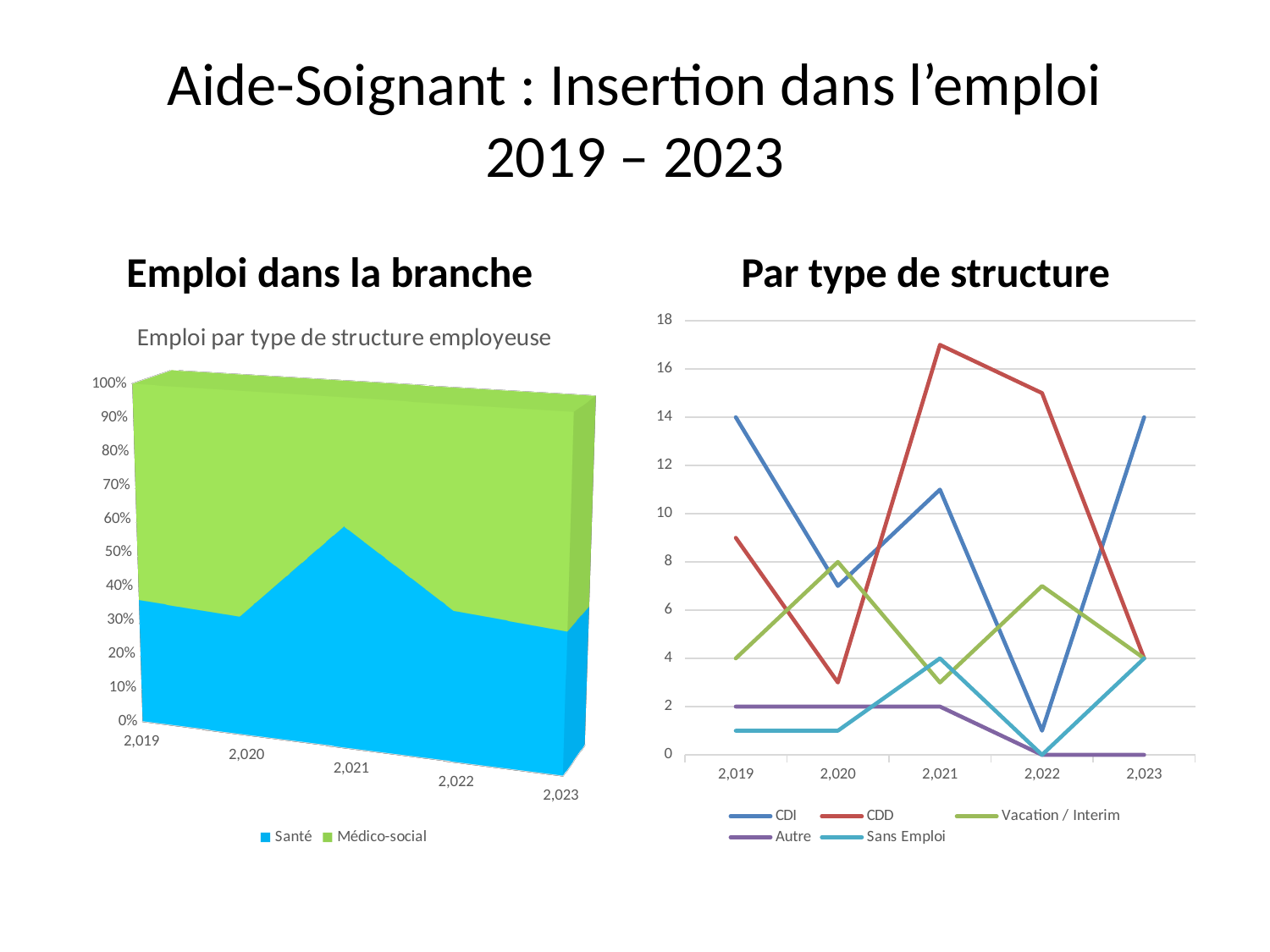
On the 'Par type de structure' chart, what is the value for CDI in 2,019? 14 On the 'Par type de structure' chart, in which year does CDD reach its highest value? 2,021 How many series does the legend of the 'Par type de structure' chart list? 5 On the 'Par type de structure' chart, does the CDD line rise or fall from 2,021 to 2,023? fall On the 'Par type de structure' chart, is the value for CDD in 2,021 greater or less than 16? greater What kind of chart is the 'Par type de structure' chart? line chart On the 'Par type de structure' chart, which series has the highest value in 2,021? CDD On the 'Par type de structure' chart, what is the difference between CDI and Vacation / Interim in 2,019? 10 On the 'Par type de structure' chart, what is the value for Autre in 2,023? 0 On the 'Par type de structure' chart, what is the value for Vacation / Interim in 2,020? 8 On the 'Par type de structure' chart, is the value for CDI in 2,022 greater or less than 2? less On the 'Par type de structure' chart, which is larger in 2,019, CDI or CDD? CDI